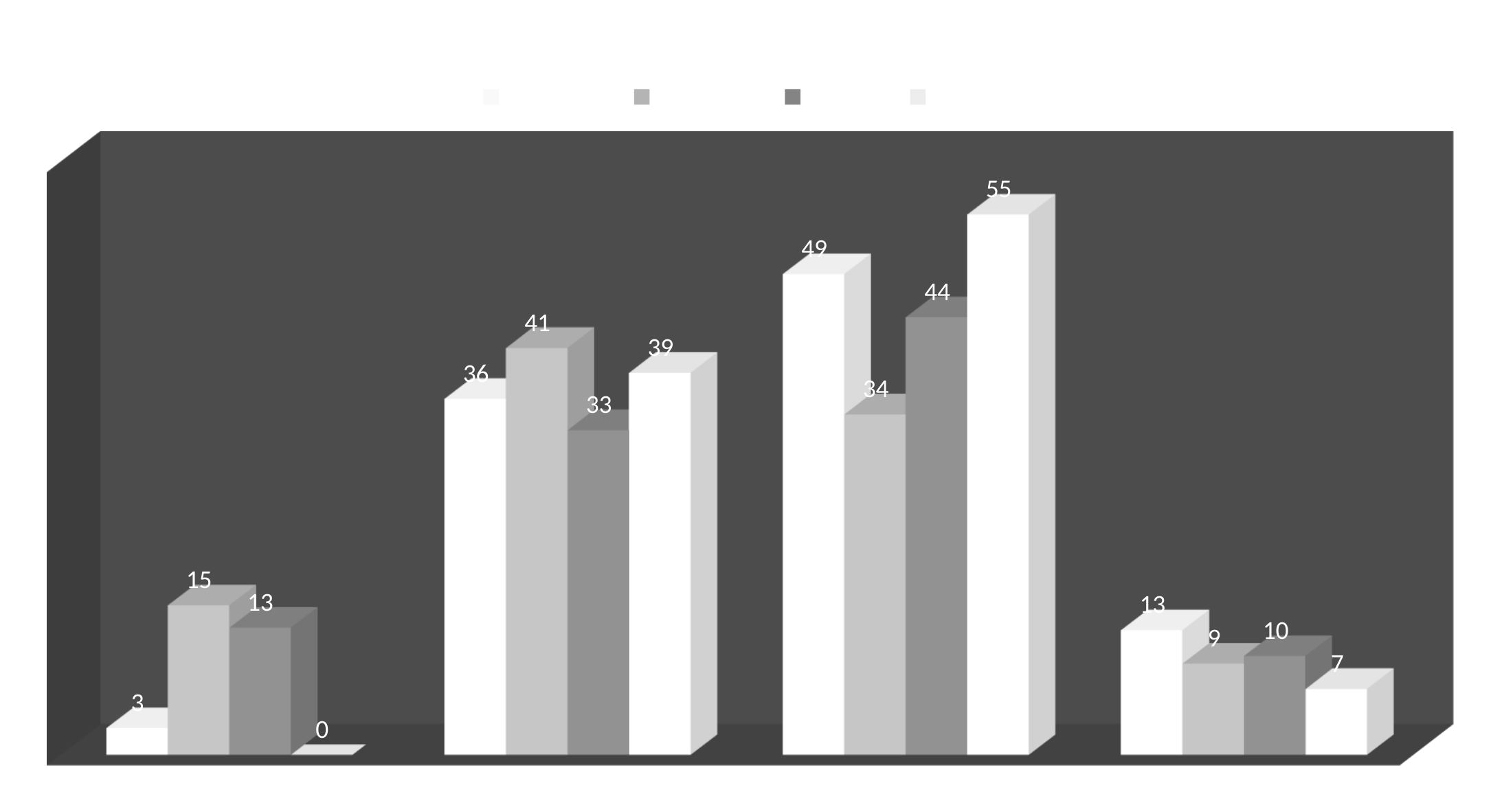
How many groups of bars are plotted on the chart? 4 What kind of chart is shown on the slide? bar chart What is the value of the tallest bar in the third group from the left? 55 Which is larger: the first bar of the second group (36) or the first bar of the third group (49)? the first bar of the third group In the first group from the left, which bar is the tallest? the second bar (15) What is the difference between the tallest bar (55) and the first bar (49) in the third group from the left? 6 What is the value of the first (leftmost) bar in the second group from the left? 36 What is the value of the last (rightmost) bar in the fourth group? 7 How many series does the legend list? 4 What is the lowest value labelled on the chart? 0 What is the highest value labelled on the chart? 55 What is the value of the second bar in the first group from the left? 15